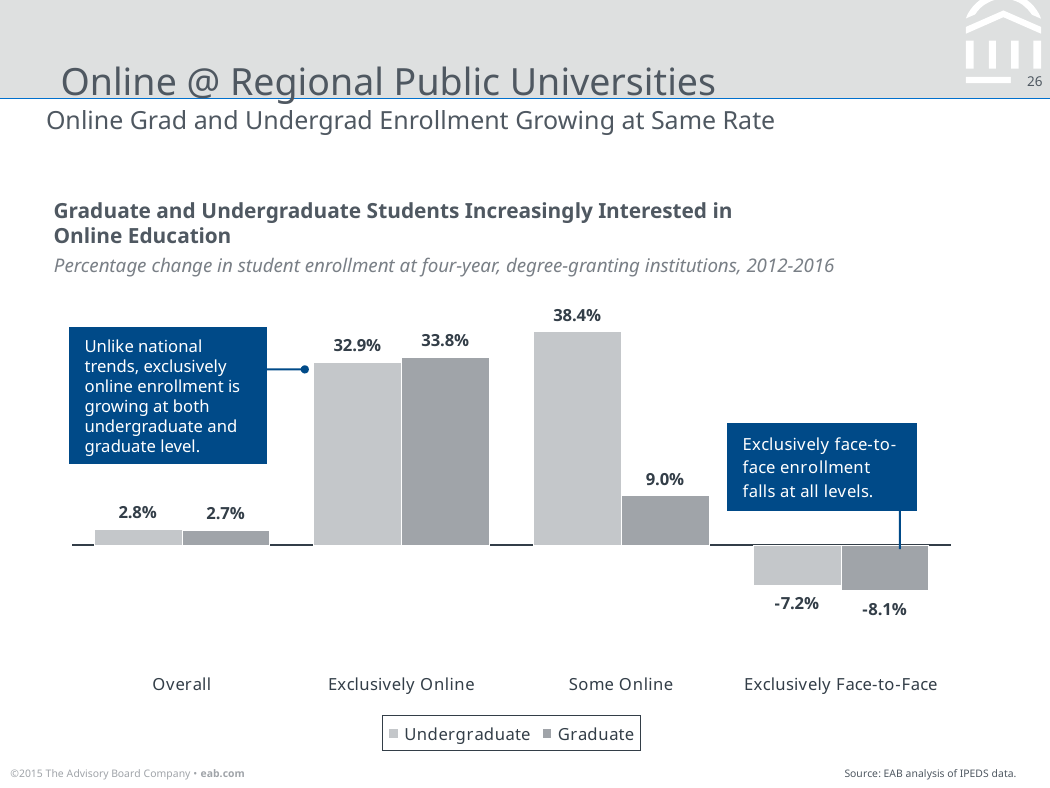
What is the Graduate value for Exclusively Online? 33.8% What is the Graduate value for Exclusively Face-to-Face? -8.1% What kind of chart is shown on the slide? Bar chart For Exclusively Online, which is larger, the Undergraduate or the Graduate value? Graduate How many series does the legend list? 2 How many categories are shown on the x axis? 4 What is the title of the chart? Graduate and Undergraduate Students Increasingly Interested in Online Education What is the Undergraduate value for Some Online? 38.4% Which category has the lowest Graduate value? Exclusively Face-to-Face What is the Undergraduate value for Overall? 2.8% What is the difference between the Undergraduate and Graduate values for Some Online? 29.4 percentage points Which category has the highest Undergraduate value? Some Online